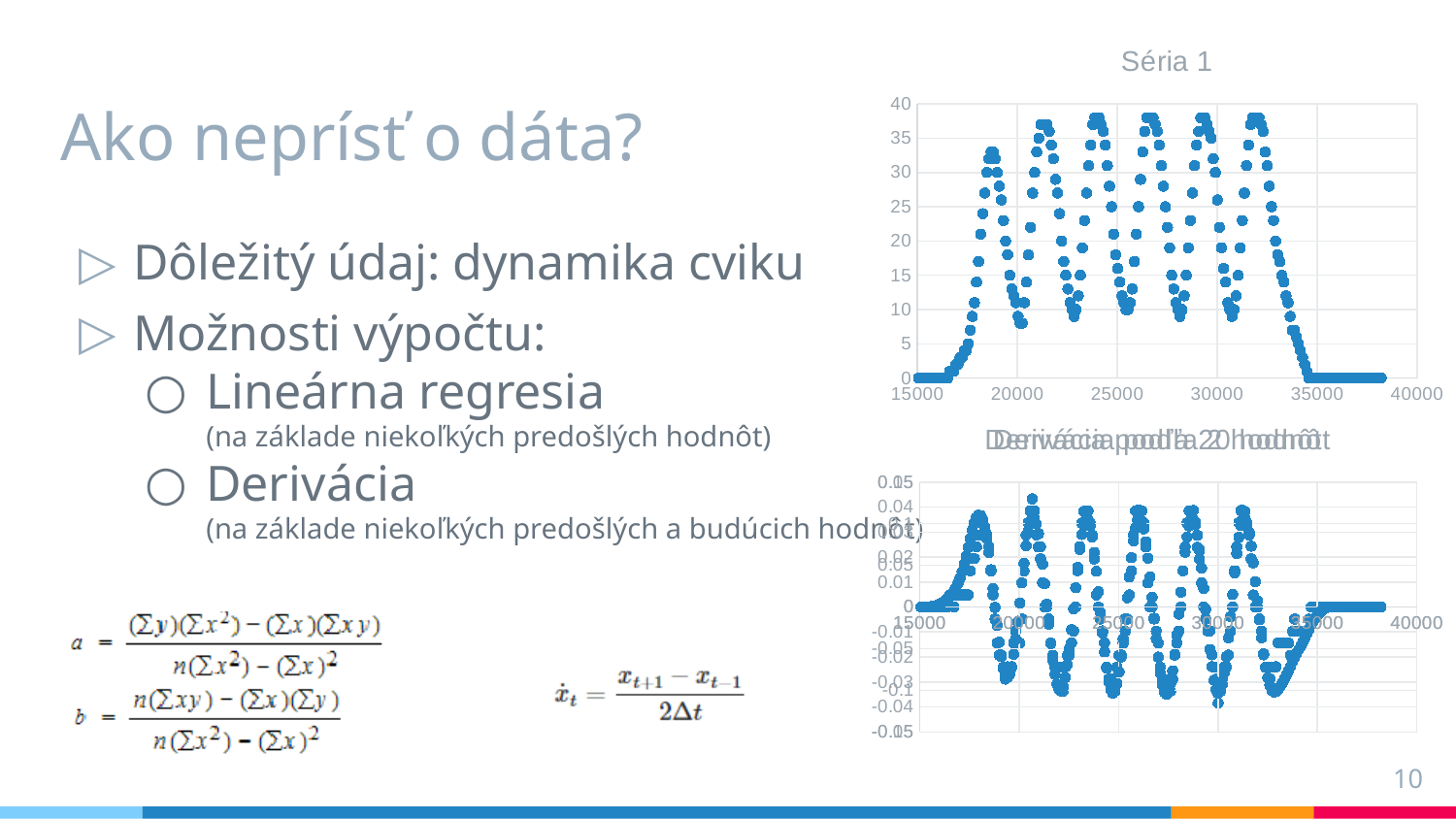
In the 'Séria 1' chart, what is the highest value shown on the vertical axis? 40 What kind of chart is the 'Séria 1' chart? scatter chart In the 'Séria 1' chart, do the values rise or fall between x = 32500 and x = 34500? fall In the 'Séria 1' chart, is the value at x = 34000 greater or less than 10? less What is the title of the chart at the top right of the slide? Séria 1 In the 'Séria 1' chart, do the values rise or fall between x = 17000 and x = 18500? rise What kind of chart is shown at the bottom right of the slide? scatter chart In the 'Séria 1' chart, is the value at x = 16000 greater or less than 5? less In the 'Séria 1' chart, what is the highest value shown on the horizontal axis? 40000 In the 'Séria 1' chart, what value do the points at x = 38000 lie on? 0 In the 'Séria 1' chart, what is the lowest value shown on the horizontal axis? 15000